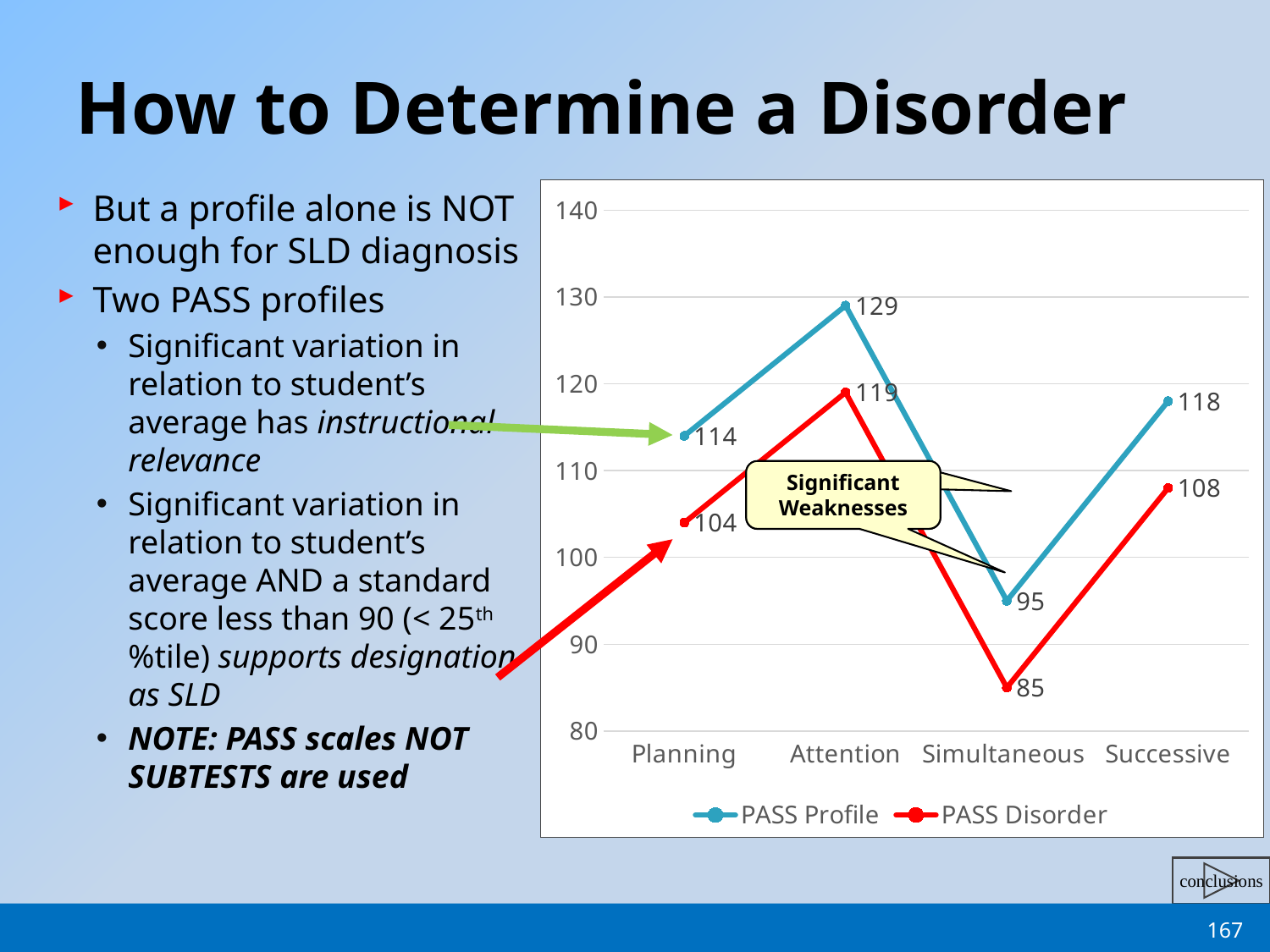
Does the PASS Profile line rise or fall from Attention to Simultaneous? fall What is the PASS Disorder value for Simultaneous? 85 Which category has the lowest PASS Disorder value? Simultaneous What is the PASS Profile value for Attention? 129 How many series does the legend list? 2 Which category has the highest PASS Profile value? Attention What does the callout box on the chart say? Significant Weaknesses What is the difference between the PASS Profile and PASS Disorder values for Planning? 10 What type of chart is shown on the slide? line chart Which is larger, the PASS Profile value for Simultaneous or the PASS Disorder value for Successive? PASS Disorder value for Successive What is the PASS Profile value for Successive? 118 How many categories are shown on the x axis? 4